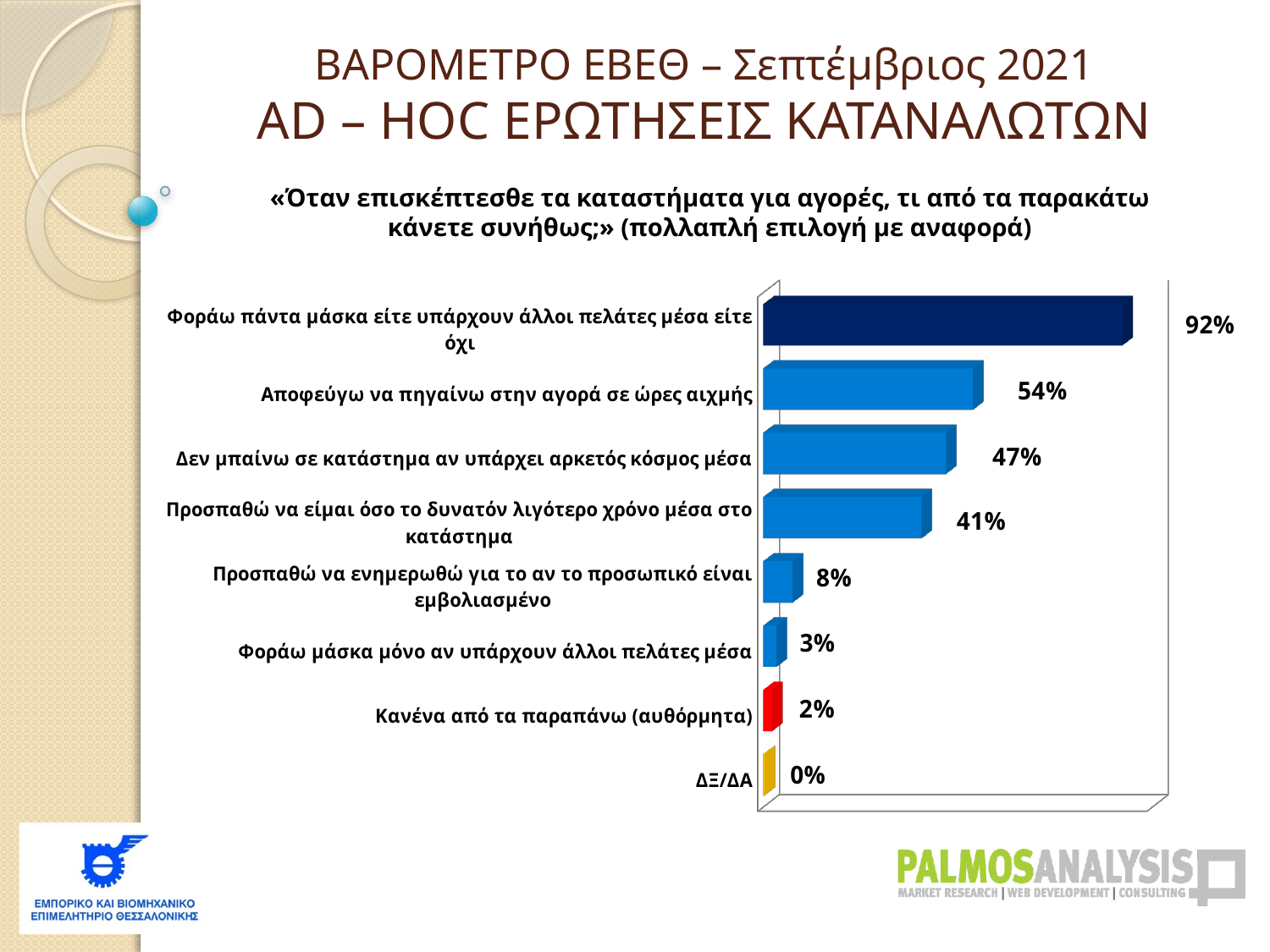
What kind of chart is shown on the slide? Bar chart Which category has the lowest value in the chart? ΔΞ/ΔΑ What colour is the bar for «Κανένα από τα παραπάνω (αυθόρμητα)»? Red What is the value shown for «Αποφεύγω να πηγαίνω στην αγορά σε ώρες αιχμής»? 54% What is the difference between the values for «Αποφεύγω να πηγαίνω στην αγορά σε ώρες αιχμής» and «Δεν μπαίνω σε κατάστημα αν υπάρχει αρκετός κόσμος μέσα»? 7% Which is larger: the value for «Φοράω μάσκα μόνο αν υπάρχουν άλλοι πελάτες μέσα» or for «Κανένα από τα παραπάνω (αυθόρμητα)»? Φοράω μάσκα μόνο αν υπάρχουν άλλοι πελάτες μέσα What is the value shown for «ΔΞ/ΔΑ»? 0% What is the difference between the values for «Φοράω πάντα μάσκα είτε υπάρχουν άλλοι πελάτες μέσα είτε όχι» and «Προσπαθώ να είμαι όσο το δυνατόν λιγότερο χρόνο μέσα στο κατάστημα»? 51% Which category has the highest value in the chart? Φοράω πάντα μάσκα είτε υπάρχουν άλλοι πελάτες μέσα είτε όχι What is the value shown for «Προσπαθώ να ενημερωθώ για το αν το προσωπικό είναι εμβολιασμένο»? 8% What percentage of respondents said «Φοράω πάντα μάσκα είτε υπάρχουν άλλοι πελάτες μέσα είτε όχι»? 92% How many categories are shown in the chart? 8